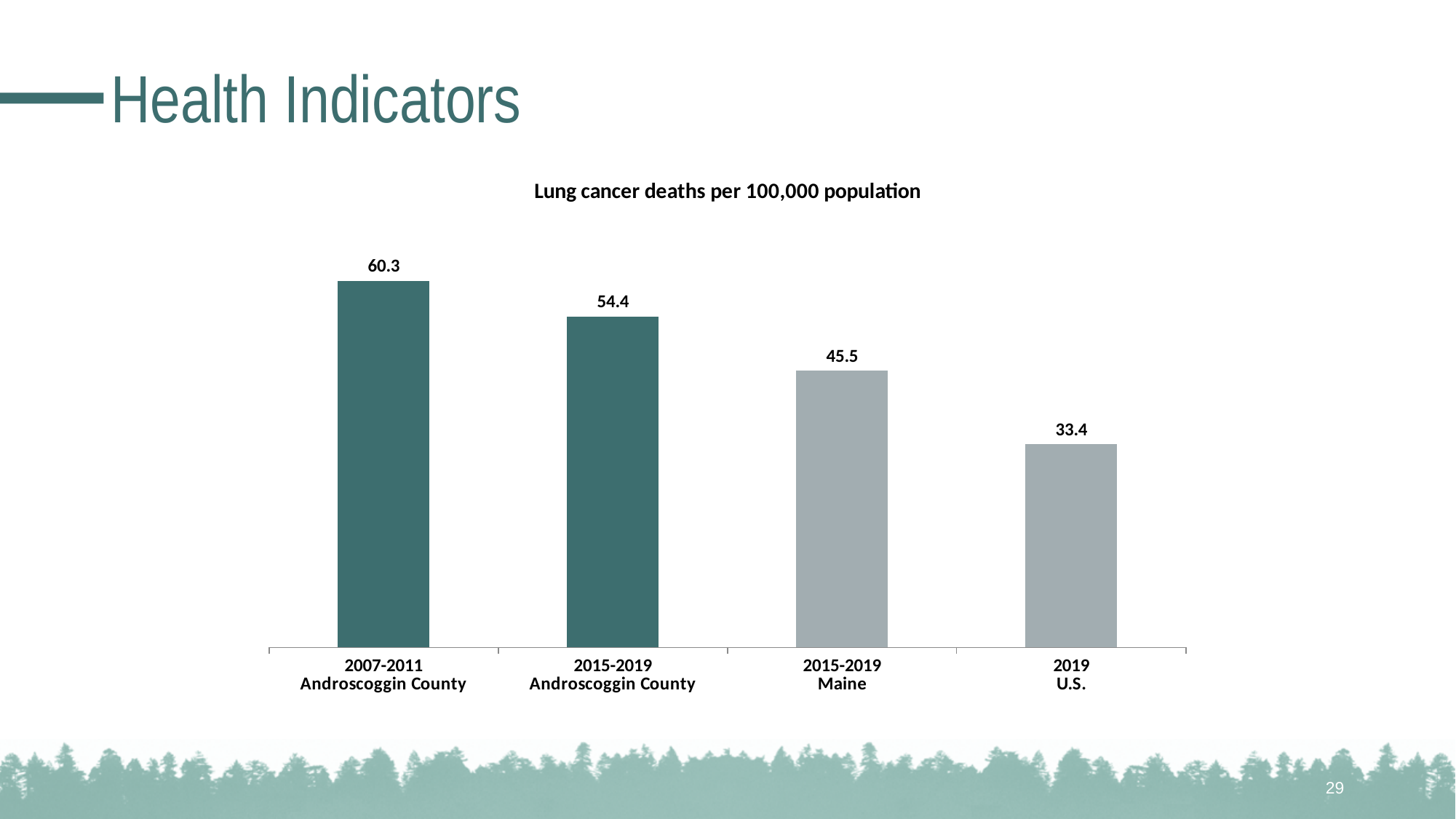
Which category has the lowest value? 2019 U.S. Which category has the highest value? 2007-2011 Androscoggin County What is the value for 2015-2019 Androscoggin County? 54.4 What is the difference between the 2007-2011 and 2015-2019 Androscoggin County values? 5.9 What is the value for 2015-2019 Maine? 45.5 What is the difference between the 2015-2019 Maine value and the 2019 U.S. value? 12.1 How many bars are shown in the chart? 4 Which is larger, the value for 2015-2019 Androscoggin County or the value for 2015-2019 Maine? 2015-2019 Androscoggin County What is the title of the chart? Lung cancer deaths per 100,000 population What is the value for 2007-2011 Androscoggin County? 60.3 What is the value for 2019 U.S.? 33.4 What kind of chart is shown on the slide? Bar chart